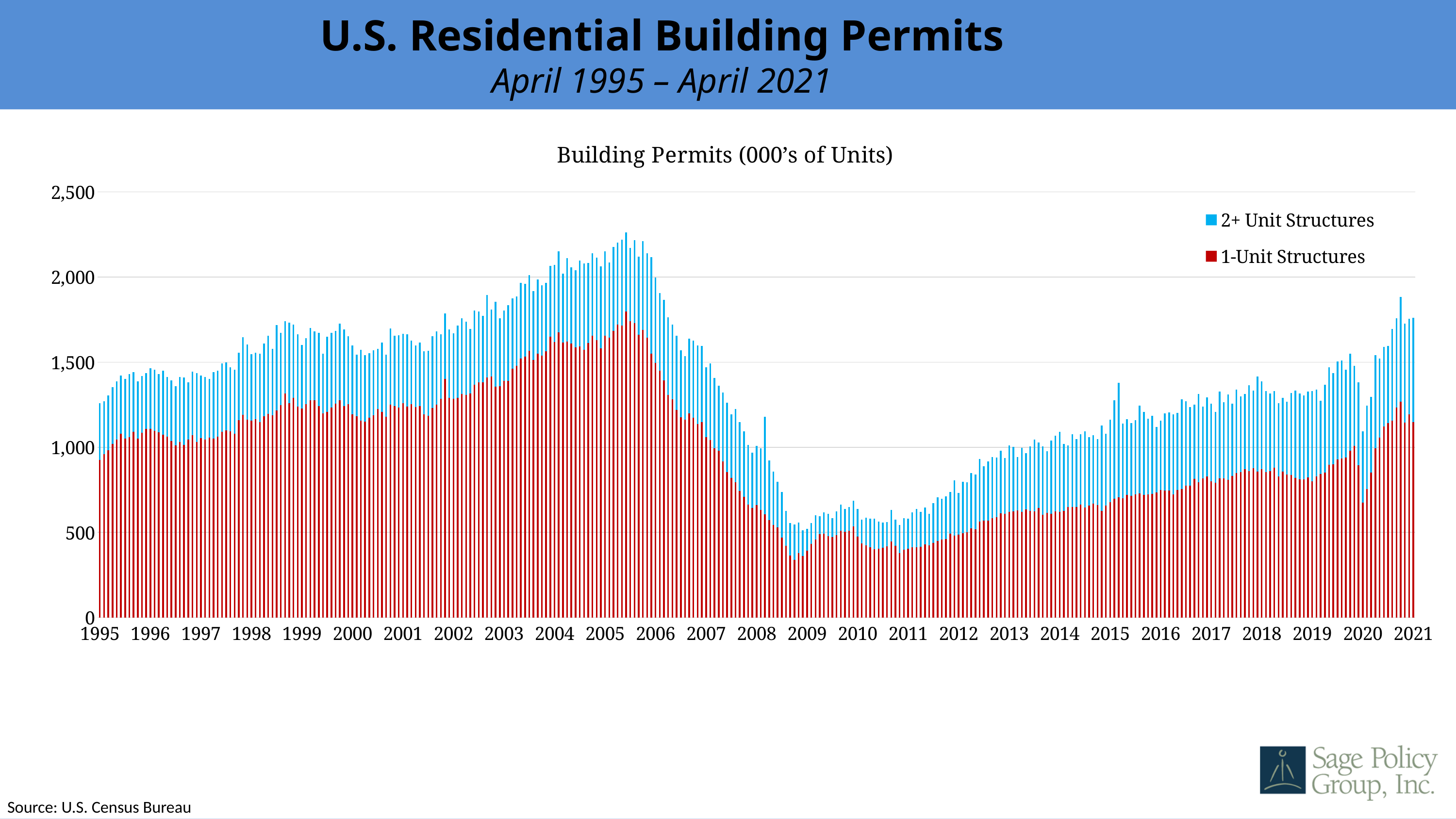
Is the 1-Unit Structures value in 2005 greater or less than 1,500? greater Which series is shown in red? 1-Unit Structures Is the total building permits value at the 2005 peak greater or less than 2,000? greater Do total building permits rise or fall between 2006 and 2009? Fall What are the two series named in the legend? 2+ Unit Structures and 1-Unit Structures Around which year do total building permits reach their highest level? 2005 How many series does the legend list? 2 Which series is larger in 2021, 1-Unit Structures or 2+ Unit Structures? 1-Unit Structures Is the 1-Unit Structures value at the start of 2009 greater or less than 500? less What kind of chart is shown on the slide? Stacked bar chart